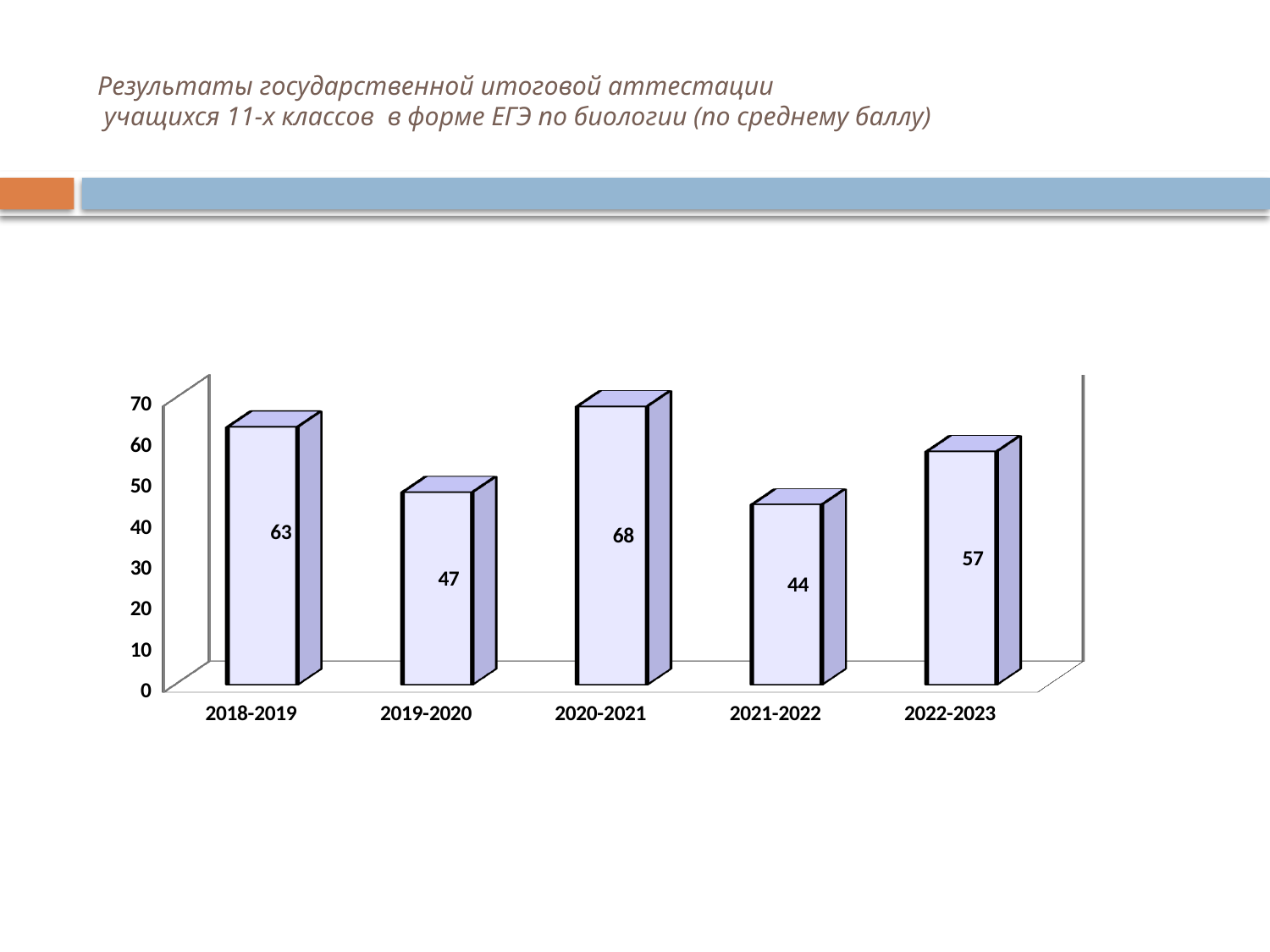
What kind of chart is shown on the slide? bar chart What is the value for 2022-2023? 57 Which is larger, the value for 2018-2019 or the value for 2022-2023? 2018-2019 Which year has the highest value? 2020-2021 Which year has the lowest value? 2021-2022 Does the value rise or fall from 2021-2022 to 2022-2023? rise What is the value for 2021-2022? 44 How many years are shown on the x axis? 5 What is the value for 2019-2020? 47 Is the value for 2019-2020 greater or less than 50? less What is the value for 2018-2019? 63 What is the difference between the values for 2020-2021 and 2021-2022? 24